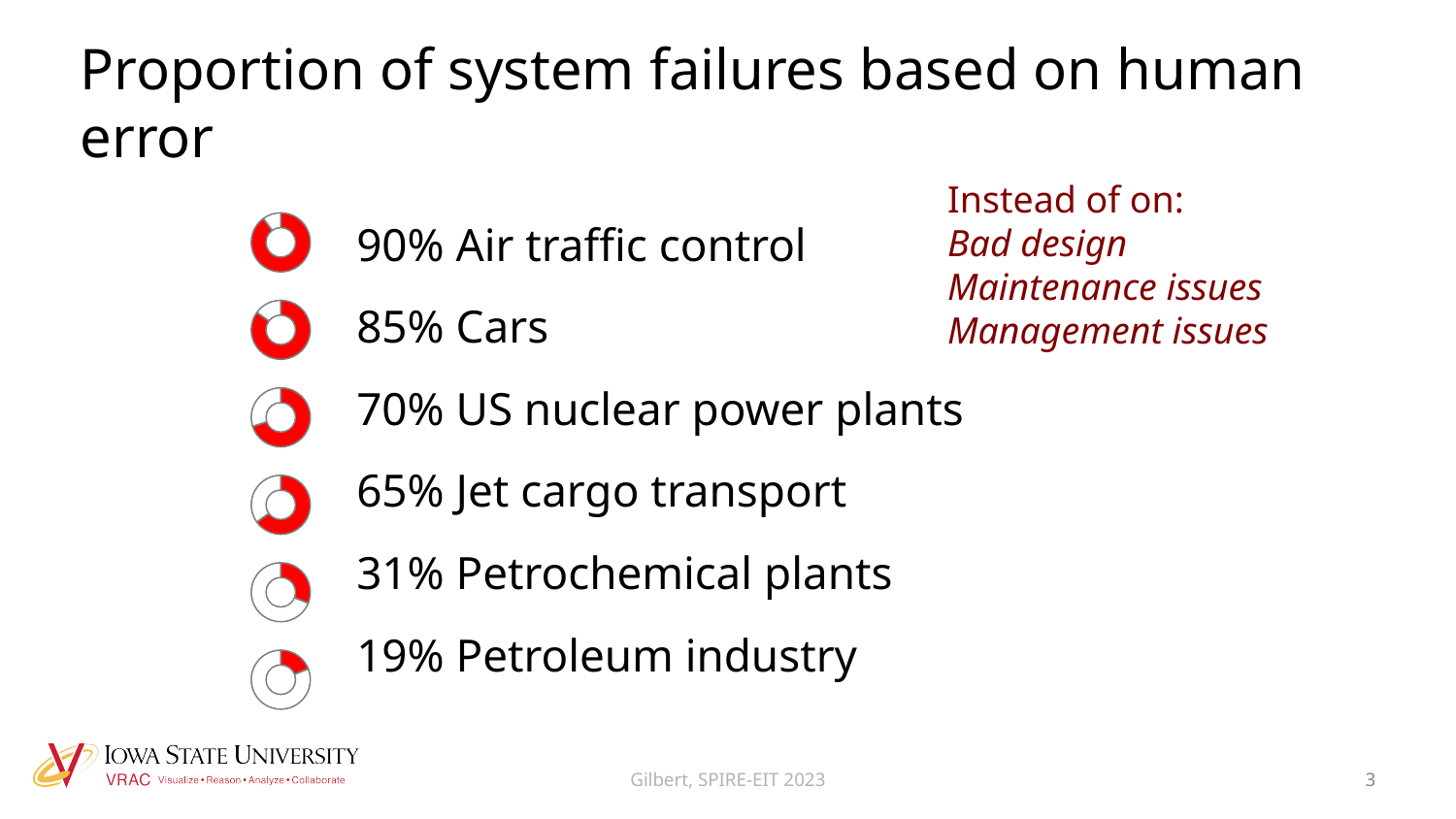
What proportion of system failures is attributed to human error for US nuclear power plants? 70% How many categories are shown with a donut chart on the slide? 6 What kind of chart is used next to each category on the slide? Donut chart Which has a larger proportion of system failures based on human error, cars or jet cargo transport? Cars What colour is used to fill the human-error share in each donut chart? Red Which category has the lowest proportion of system failures based on human error? Petroleum industry What proportion of system failures is attributed to human error for cars? 85% What is the difference between the human-error proportion for air traffic control and for petrochemical plants? 59% What proportion of system failures is attributed to human error for the petroleum industry? 19% What proportion of system failures is attributed to human error for air traffic control? 90% What proportion of system failures is attributed to human error for jet cargo transport? 65% Which category has the highest proportion of system failures based on human error? Air traffic control